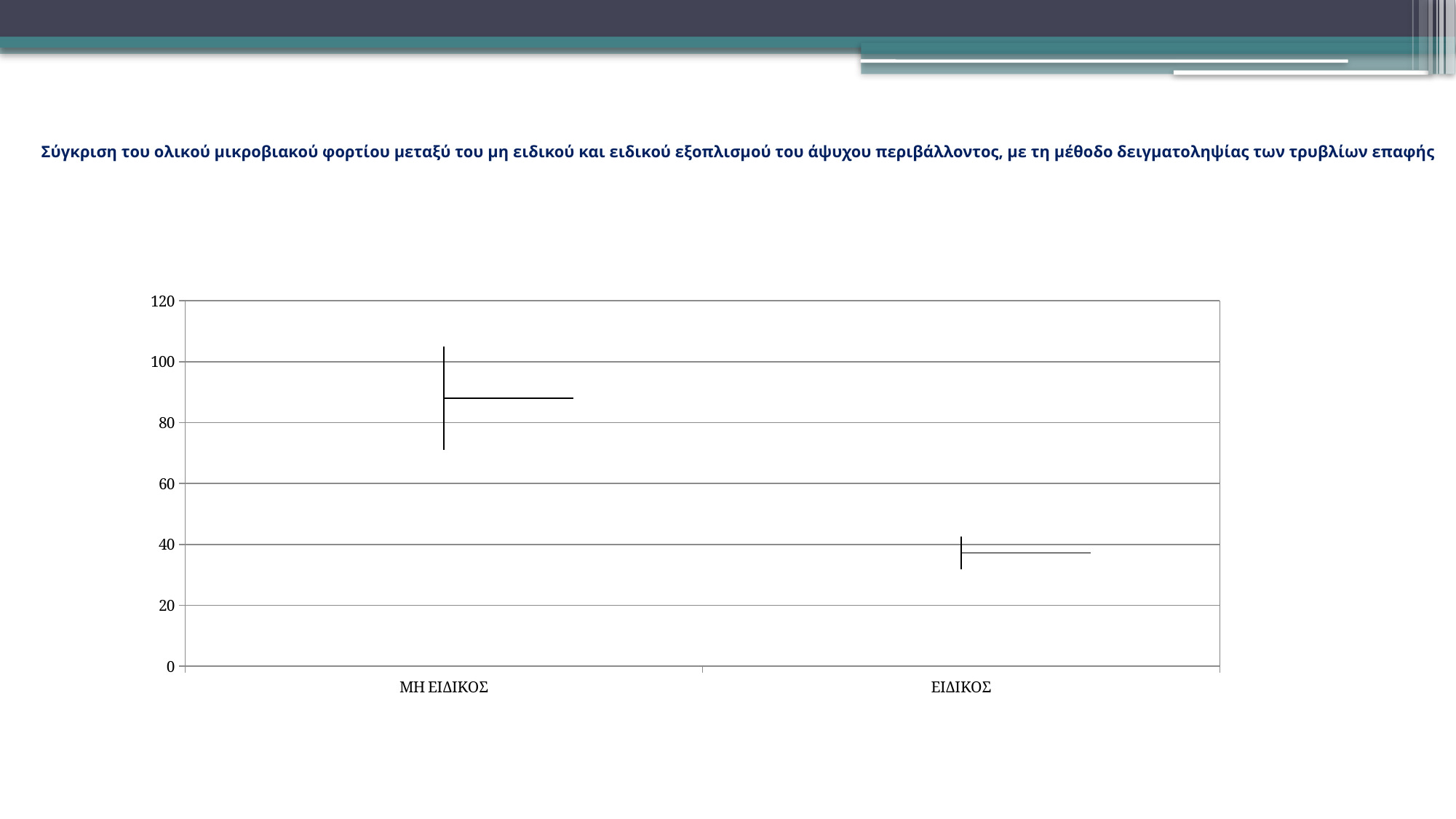
Is the value for ΕΙΔΙΚΟΣ greater or less than 20? greater What is the maximum value shown on the vertical axis of the chart? 120 Which category has the higher value, ΜΗ ΕΙΔΙΚΟΣ or ΕΙΔΙΚΟΣ? ΜΗ ΕΙΔΙΚΟΣ Which category shows the lowest value in the chart? ΕΙΔΙΚΟΣ What is the label of the rightmost category on the x axis? ΕΙΔΙΚΟΣ How many categories are shown on the x axis of the chart? 2 Which category shows the highest value in the chart? ΜΗ ΕΙΔΙΚΟΣ Do the values rise or fall moving from ΜΗ ΕΙΔΙΚΟΣ to ΕΙΔΙΚΟΣ along the x axis? fall Is the value for ΕΙΔΙΚΟΣ greater or less than 60? less